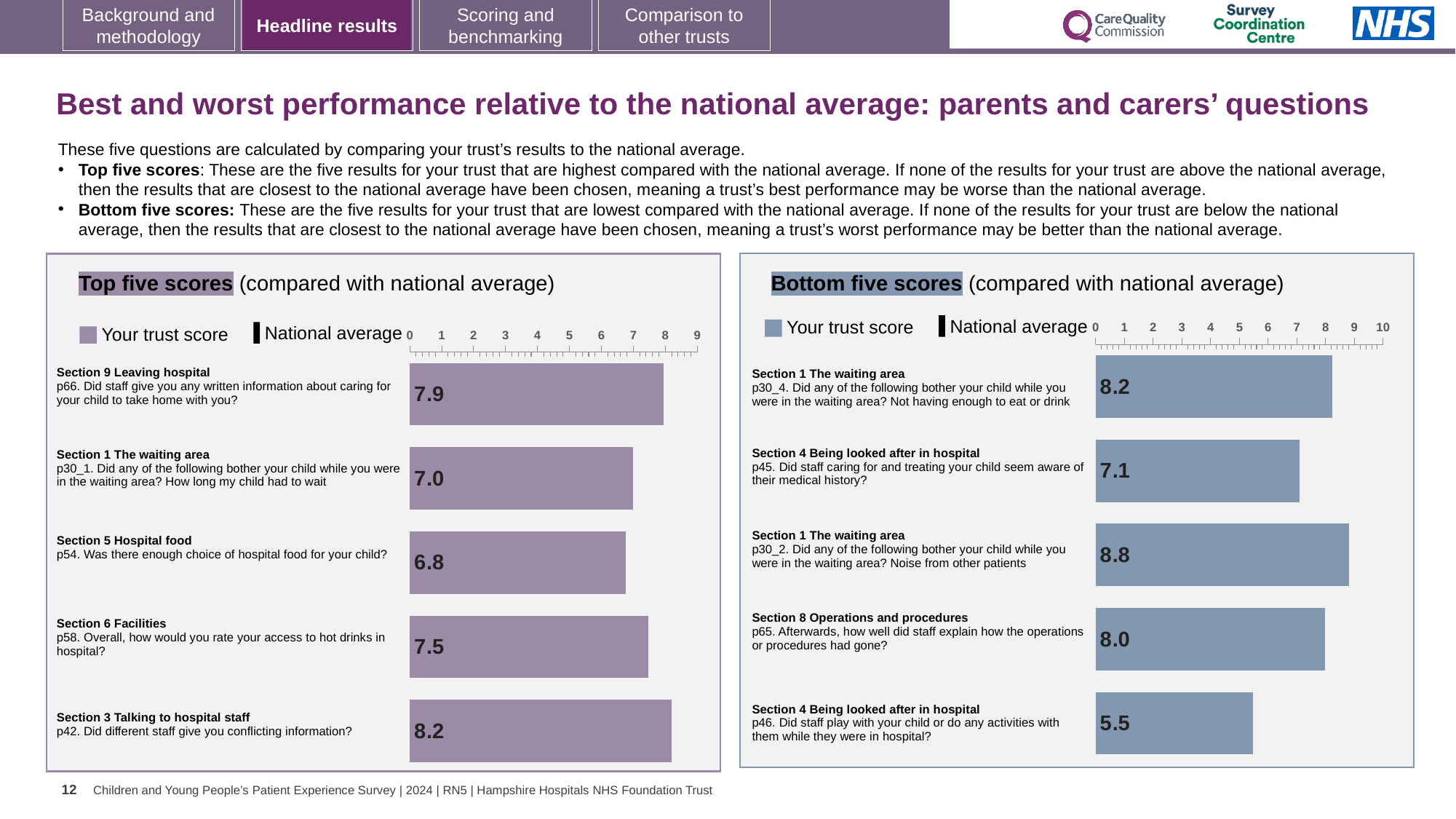
What kind of chart is the Top five scores chart? Bar chart In the Bottom five scores chart, what is the trust score for p46 (staff playing with your child or doing activities)? 5.5 In the Top five scores chart, what is the trust score for p54 (enough choice of hospital food)? 6.8 In the Bottom five scores chart, which question has the highest trust score? p30_2. Noise from other patients In the Top five scores chart, what is the difference between the trust scores for p42 and p30_1? 1.2 How many questions are shown in the Bottom five scores chart? 5 In the Top five scores chart, what is the trust score for p66 (written information about caring for your child to take home)? 7.9 In the Bottom five scores chart, what is the trust score for p65 (how well staff explained how operations or procedures had gone)? 8.0 In the Bottom five scores chart, which question has the lowest trust score? p46. Did staff play with your child or do any activities with them while they were in hospital? In the Top five scores chart, which question has the highest trust score? p42. Did different staff give you conflicting information? In the Bottom five scores chart, is the trust score for p30_4 or p45 larger? p30_4 In the Top five scores chart, which question has the lowest trust score? p54. Was there enough choice of hospital food for your child?